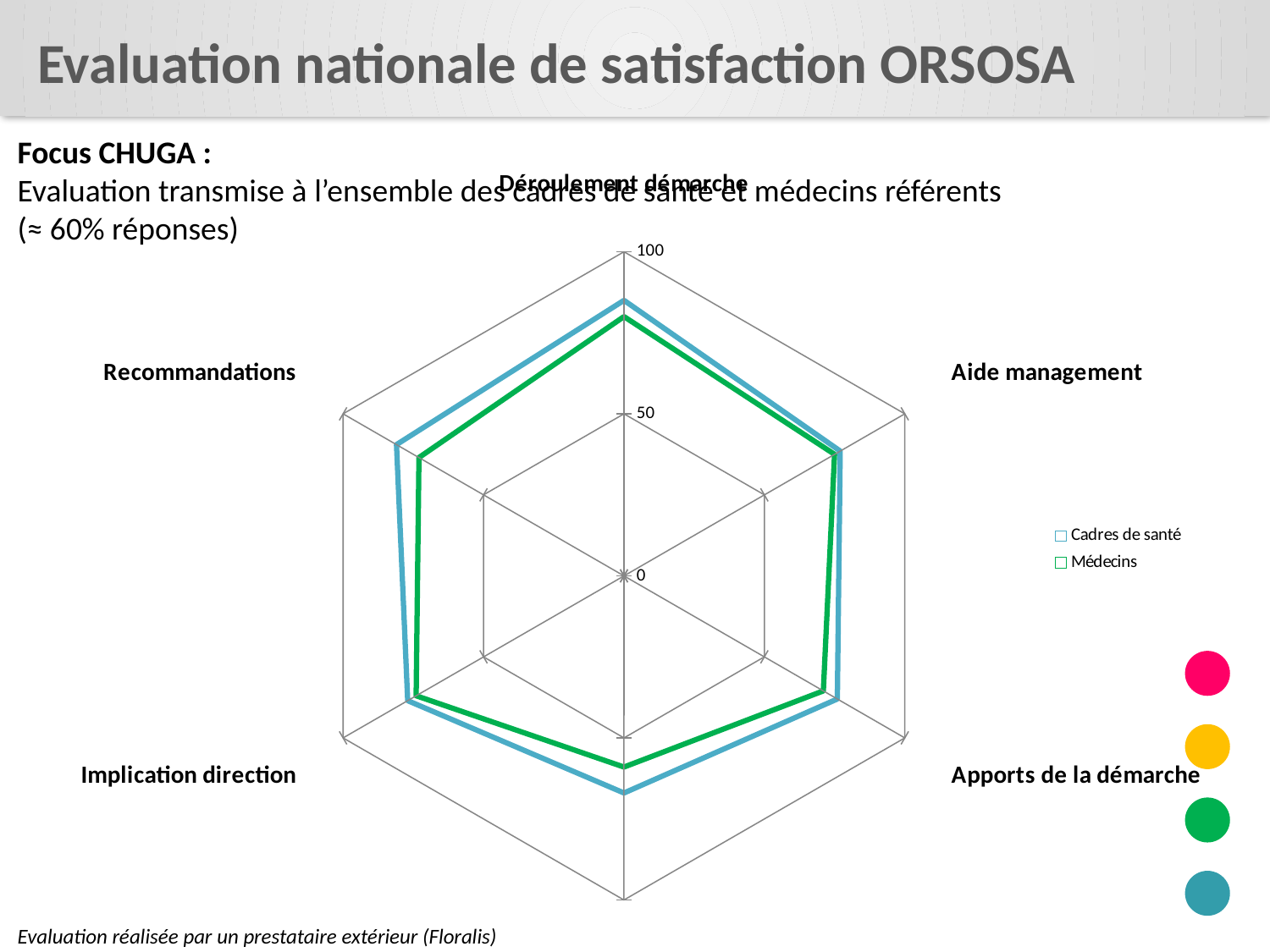
What kind of chart is shown on the slide? radar chart Is the Cadres de santé value for Apports de la démarche greater or less than 100? less What are the two series named in the chart's legend? Cadres de santé and Médecins How many series does the chart's legend list? 2 Is the Cadres de santé value for Déroulement démarche greater or less than 50? greater Which colour represents the Médecins series in the chart? green For Recommandations, which series has the higher value, Cadres de santé or Médecins? Cadres de santé What is the maximum value shown on the chart's radial axis? 100 For Déroulement démarche, which series has the higher value, Cadres de santé or Médecins? Cadres de santé Is the Médecins value for Implication direction greater or less than 50? greater